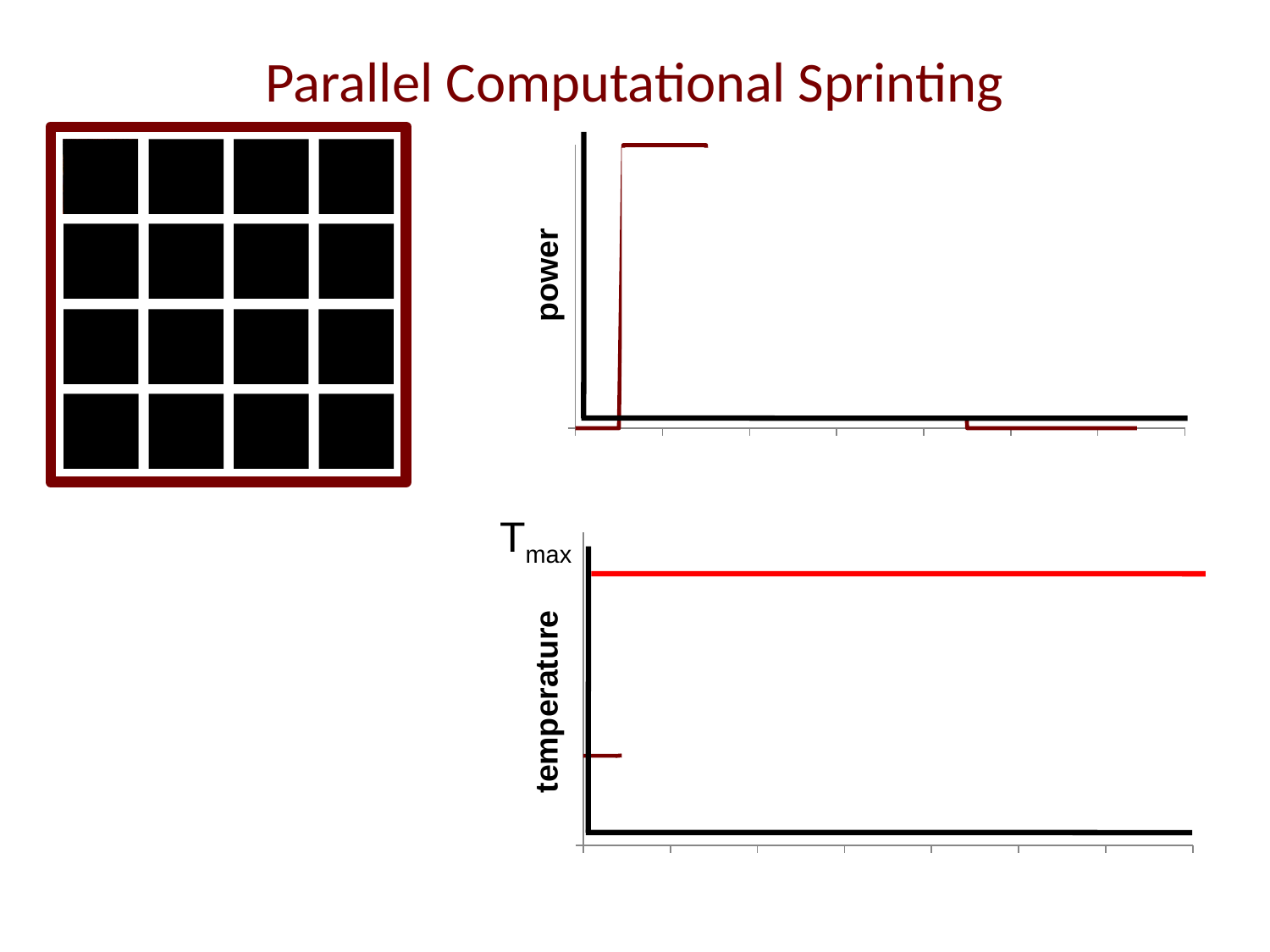
What kind of chart is the top chart on the slide? line chart In the top chart, does the power line rise or fall at the start of the x axis? rise What is the y-axis label of the top chart? power In the top chart, does the power line rise or fall toward the right end of the x axis? fall In the bottom chart, is the dark red temperature line above or below the Tmax line? below In the bottom chart, what label is given to the horizontal red line? Tmax How many charts are shown on the slide? 2 What is the y-axis label of the bottom chart? temperature What kind of chart is the bottom chart on the slide? line chart